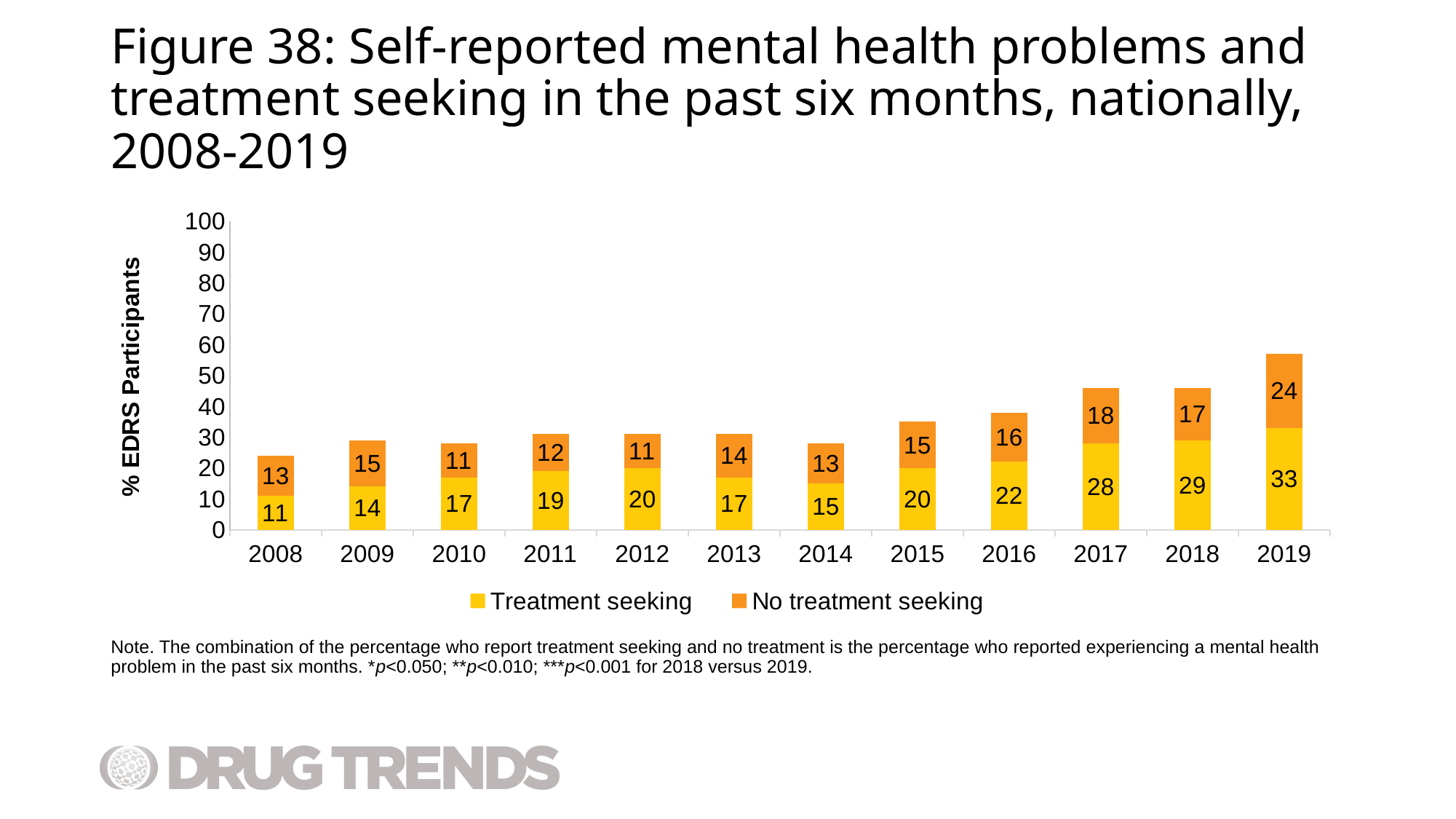
Which year has the highest value for Treatment seeking? 2019 What is the total of the stacked bar for 2019? 57 How many years are shown on the x axis? 12 How many series does the legend list? 2 What is the difference between the Treatment seeking values for 2019 and 2018? 4 What kind of chart is shown? Stacked bar chart What is the value for Treatment seeking in 2019? 33 What is the total of the stacked bar for 2008? 24 What is the value for No treatment seeking in 2009? 15 Which is larger, the No treatment seeking value for 2017 or for 2016? 2017 What is the label of the y axis? % EDRS Participants Which year has the lowest value for Treatment seeking? 2008